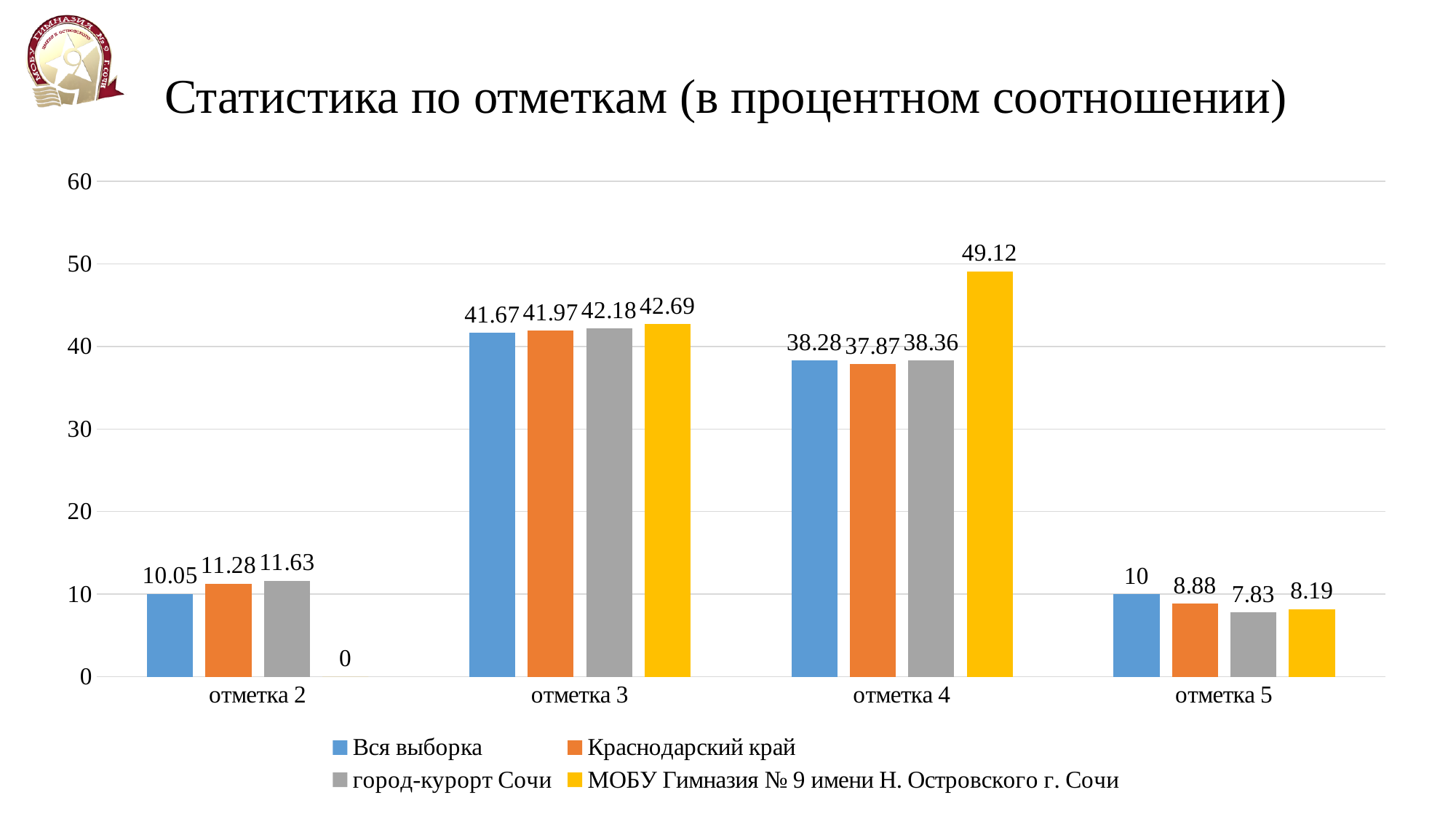
What is the value for МОБУ Гимназия № 9 имени Н. Островского г. Сочи at отметка 4? 49.12 What is the value for Вся выборка at отметка 2? 10.05 Which is larger at отметка 5: Вся выборка or Краснодарский край? Вся выборка What is the value for город-курорт Сочи at отметка 5? 7.83 What is the title of the slide? Статистика по отметкам (в процентном соотношении) Which category has the highest value for the МОБУ Гимназия № 9 имени Н. Островского г. Сочи series? отметка 4 What kind of chart is shown on the slide? bar chart What is the value for Краснодарский край at отметка 3? 41.97 How many categories are shown on the x axis? 4 Which category has the lowest value for the МОБУ Гимназия № 9 имени Н. Островского г. Сочи series? отметка 2 How many series does the legend list? 4 What is the difference between the МОБУ Гимназия № 9 value and the Вся выборка value at отметка 4? 10.84